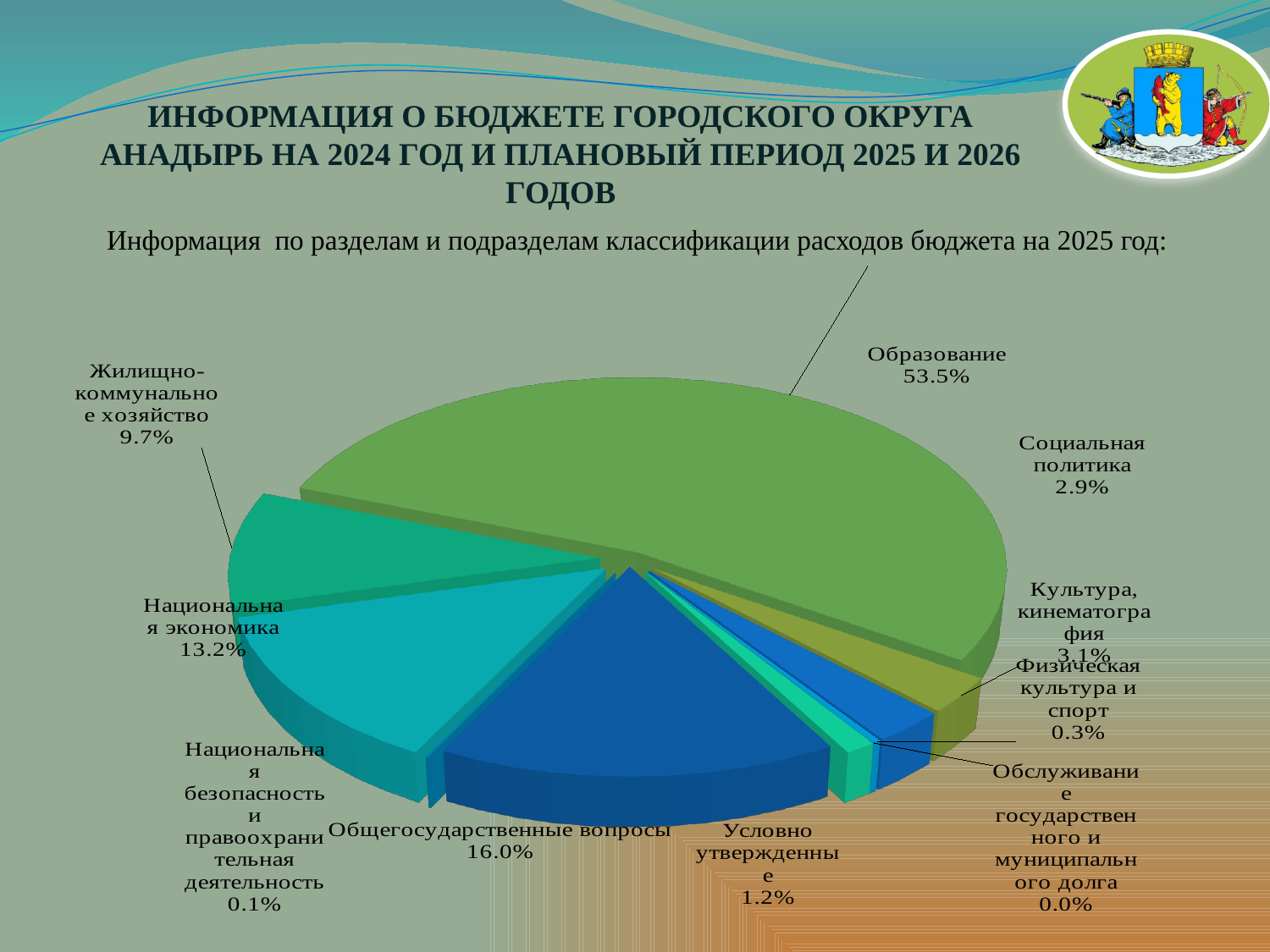
How many sections (slices) are shown in the pie chart? 10 Which section has the smallest share of the pie? Обслуживание государственного и муниципального долга What is the difference between the shares of Образование and Общегосударственные вопросы? 37.5% Which section has the largest share of the pie? Образование What percentage is shown for Национальная экономика? 13.2% What share is labelled for Жилищно-коммунальное хозяйство? 9.7% Which is larger: the share of Культура, кинематография or the share of Социальная политика? Культура, кинематография What type of chart is shown on the slide? Pie chart What share of the 2025 budget expenditures goes to Образование? 53.5% Which year's budget expenditures does the pie chart describe? 2025 What percentage is shown for Условно утвержденные? 1.2% What percentage is shown for Общегосударственные вопросы? 16.0%